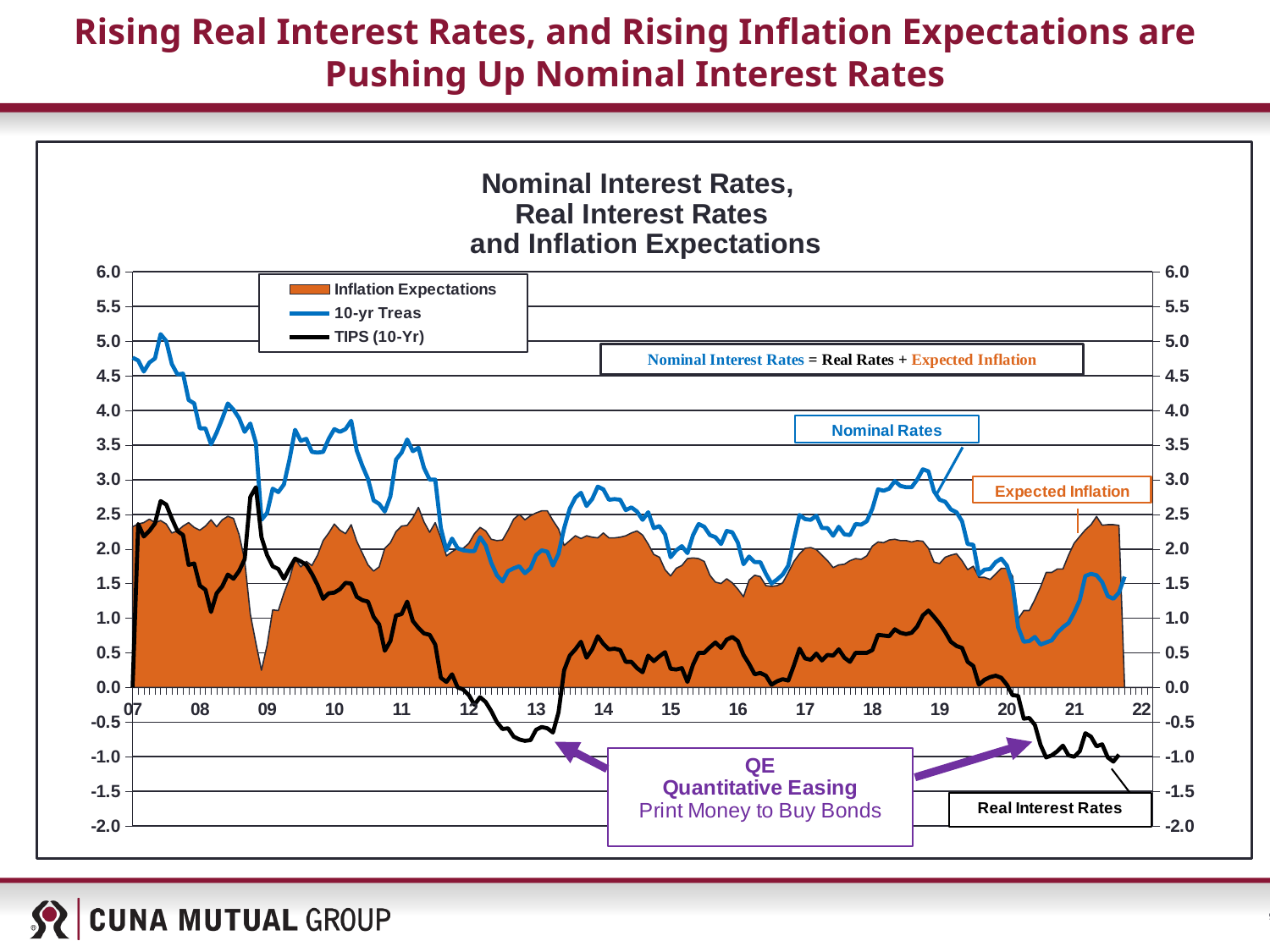
Which series is higher at the start of 2007, 10-yr Treas or TIPS (10-Yr)? 10-yr Treas What are the three series named in the legend? Inflation Expectations, 10-yr Treas, TIPS (10-Yr) What colour is the Inflation Expectations series drawn in? Orange Does the TIPS (10-Yr) series overall rise or fall from 2007 to 2022? Fall How many year labels are shown along the x axis? 16 How many series does the legend list? 3 Is the TIPS (10-Yr) value in 2021 greater or less than -0.5? less Is the 10-yr Treas value at its 2018 peak greater or less than 2.5? greater Does the 10-yr Treas series overall rise or fall from 2007 to 2022? Fall Is the 10-yr Treas value at the start of 2007 greater or less than 4.0? greater